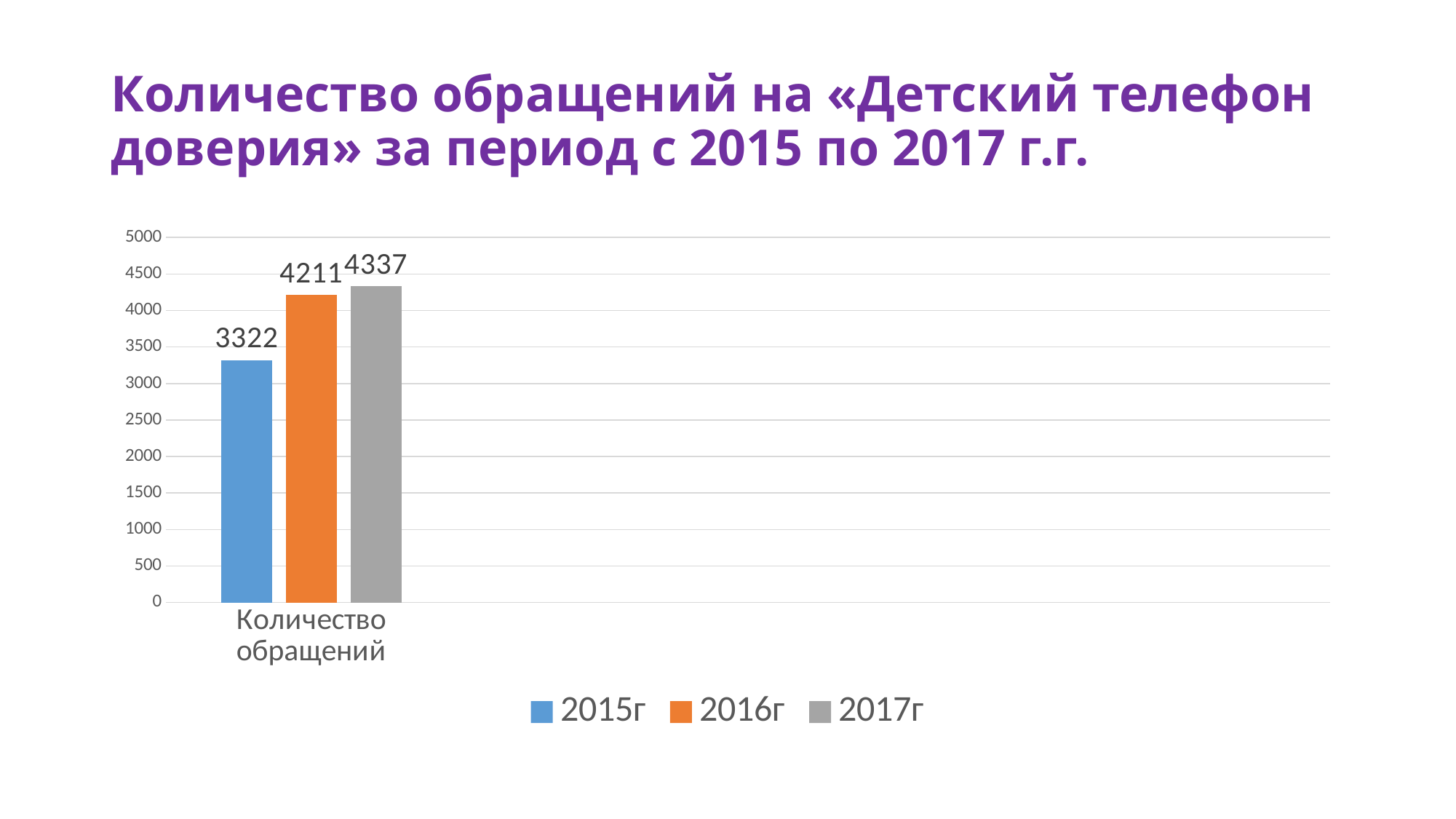
What is the value for 2017г? 4337 What is the value for 2015г? 3322 Which year has the lowest number of обращений? 2015г Which is larger, the value for 2015г or the value for 2016г? 2016г What is the value for 2016г? 4211 How many series does the legend list? 3 Which year has the highest number of обращений? 2017г What kind of chart is shown on the slide? bar chart Is the value for 2015г greater or less than 3500? less What is the difference between the values for 2016г and 2015г? 889 What is the difference between the values for 2017г and 2016г? 126 What colour is the bar for 2016г? orange